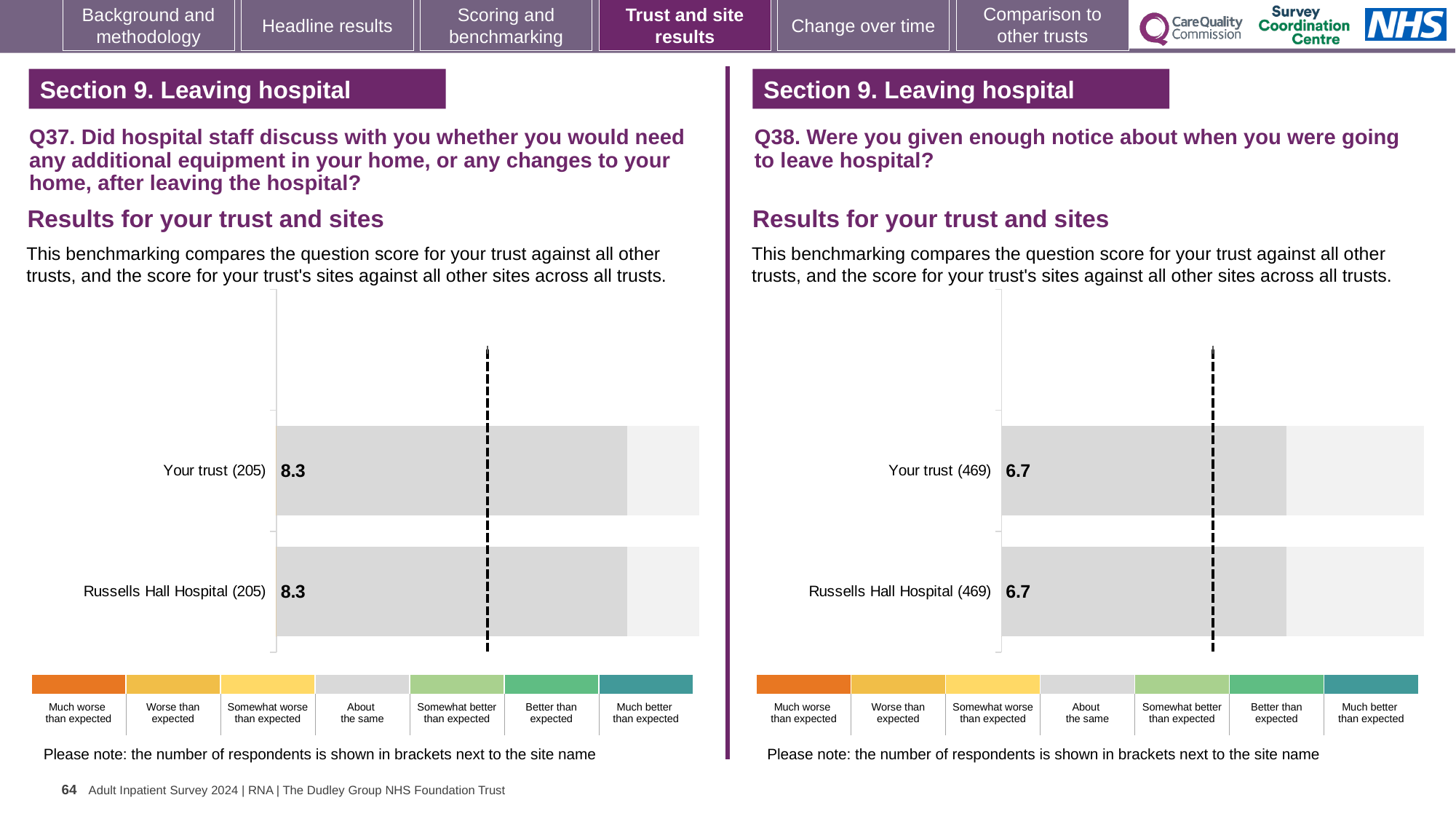
How many bars are plotted in the Q37 chart on the left? 2 In the Q38 chart on the right, what is the score for Russells Hall Hospital? 6.7 How many bars are plotted in the Q38 chart on the right? 2 In the Q38 chart on the right, what is the score for Your trust? 6.7 In the Q37 chart on the left, what is the difference between the score for Your trust and the score for Russells Hall Hospital? 0 What type of chart is used for the Q38 results on the right? Bar chart In the Q37 chart on the left, how many respondents are shown in brackets next to Russells Hall Hospital? 205 How many categories does the colour key below each chart list, from 'Much worse than expected' to 'Much better than expected'? 7 In the Q37 chart on the left, what is the score for Your trust? 8.3 In the Q38 chart on the right, what is the difference between the score for Your trust and the score for Russells Hall Hospital? 0 In the Q38 chart on the right, how many respondents are shown in brackets next to Your trust? 469 In the Q37 chart on the left, what is the score for Russells Hall Hospital? 8.3